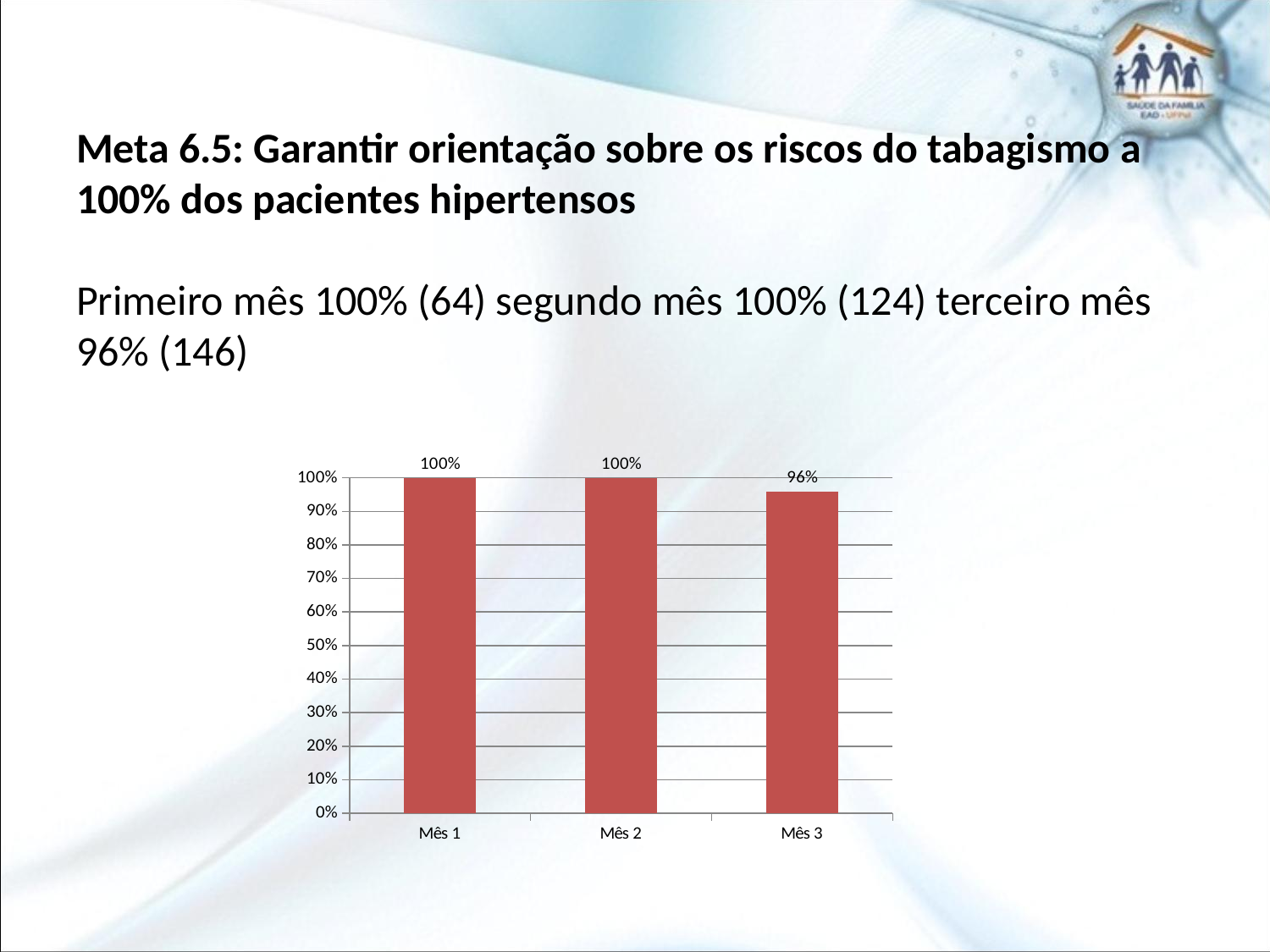
What colour are the bars in the chart? red Do the values rise or fall from Mês 2 to Mês 3? fall How many categories are shown on the x axis? 3 Is the value for Mês 3 greater or less than 90%? greater What kind of chart is shown on the slide? bar chart Which category has the lowest value? Mês 3 What is the difference between the values for Mês 1 and Mês 3? 4% What is the value for Mês 2? 100% What is the highest value shown on the y axis? 100% What is the value for Mês 3? 96% Which is larger, the value for Mês 2 or the value for Mês 3? Mês 2 What is the value for Mês 1? 100%